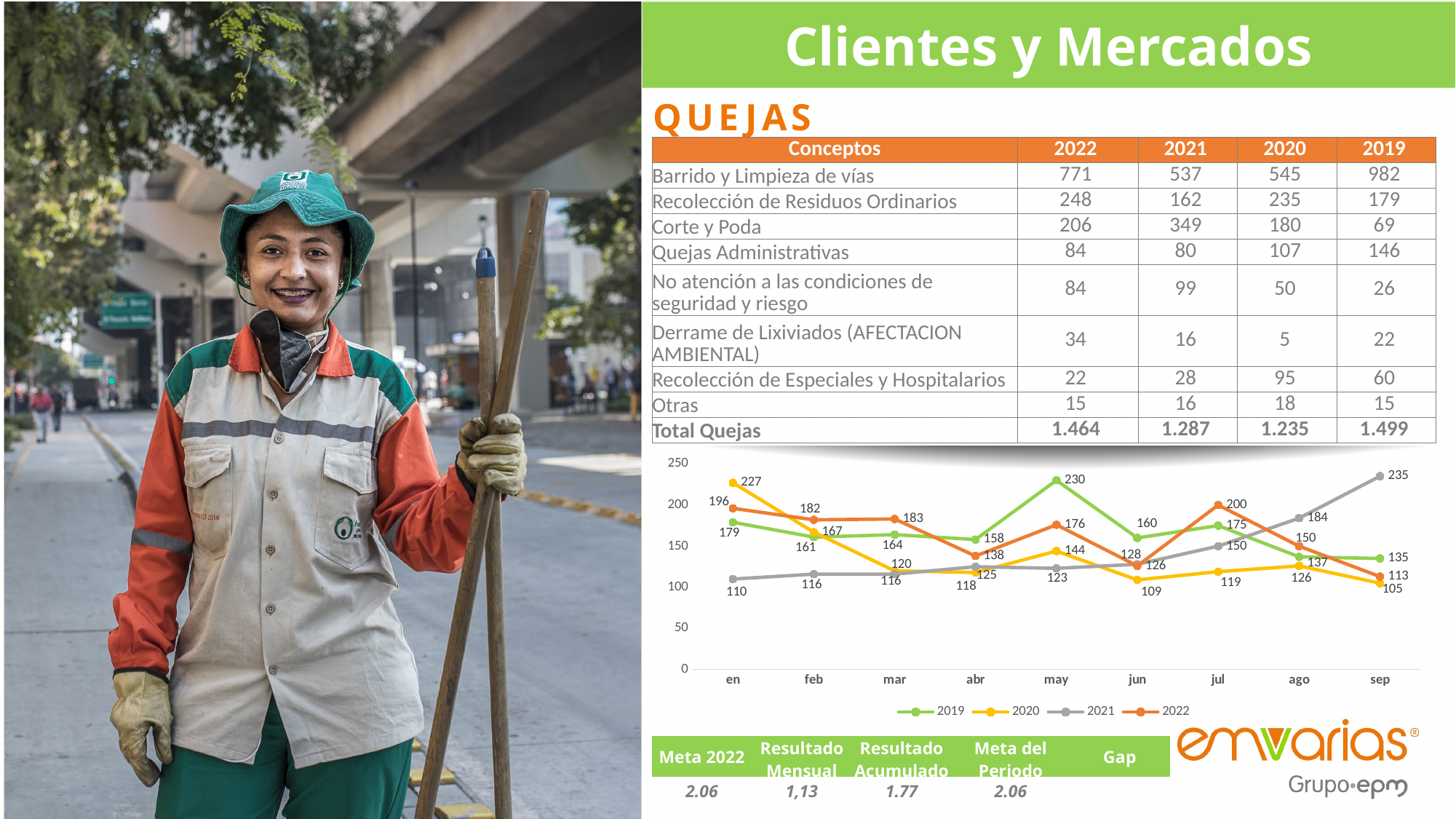
How many months are plotted along the x axis of the line chart? 9 What kind of chart is shown below the Quejas table? line chart In the line chart, what is the value for 2020 in en? 227 In the line chart, in which month does the 2021 series reach its highest value? sep In the line chart, does the 2021 series generally rise or fall from en to sep? rise In the line chart, in which month does the 2019 series reach its highest value? may How many series does the legend of the line chart list? 4 In the line chart, what is the difference between the 2021 value in sep (235) and the 2022 value in sep (113)? 122 In the line chart, in which month is the 2021 series lowest? en In the line chart, what is the value for 2021 in sep? 235 In the line chart, which series has the higher value in may: 2019 or 2021? 2019 In the line chart, what is the value for 2022 in jul? 200